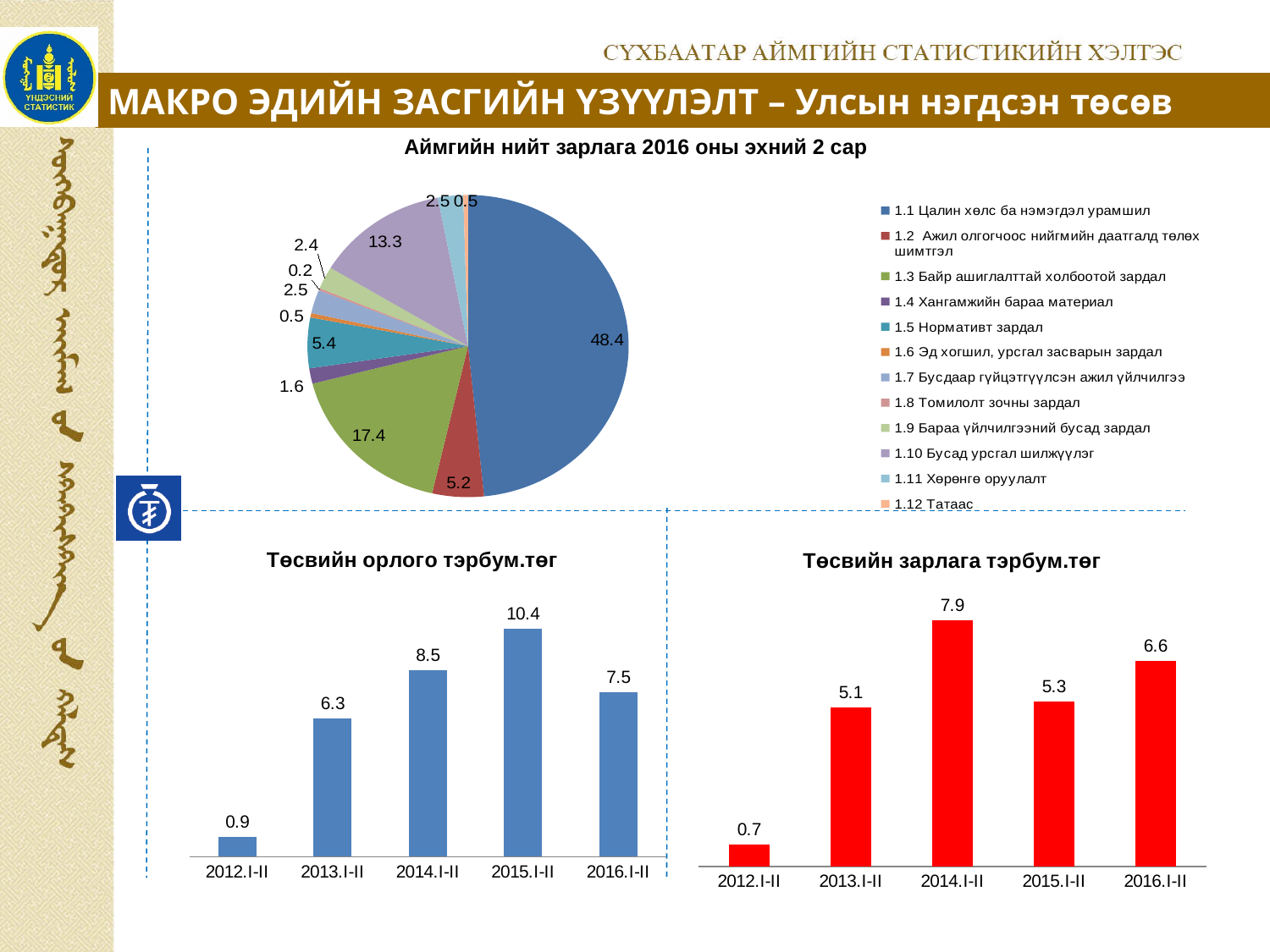
What kind of chart is the chart titled 'Аймгийн нийт зарлага 2016 оны эхний 2 сар'? pie chart In the bar chart titled 'Төсвийн зарлага тэрбум.төг', which period has the lowest value? 2012.I-II How many periods are shown on the x axis of the bar chart titled 'Төсвийн орлого тэрбум.төг'? 5 In the pie chart titled 'Аймгийн нийт зарлага 2016 оны эхний 2 сар', what is the value of the largest slice? 48.4 In the bar chart titled 'Төсвийн орлого тэрбум.төг', which period has the highest value? 2015.I-II In the bar chart titled 'Төсвийн орлого тэрбум.төг', what is the difference between the values for 2015.I-II and 2016.I-II? 2.9 In the bar chart titled 'Төсвийн зарлага тэрбум.төг', what is the value for 2016.I-II? 6.6 In the bar chart titled 'Төсвийн орлого тэрбум.төг', do the values rise or fall from 2012.I-II to 2015.I-II? rise In the bar chart titled 'Төсвийн орлого тэрбум.төг', what is the value for 2015.I-II? 10.4 How many entries does the legend of the pie chart titled 'Аймгийн нийт зарлага 2016 оны эхний 2 сар' list? 12 What colour are the bars in the chart titled 'Төсвийн зарлага тэрбум.төг'? red In the bar chart titled 'Төсвийн зарлага тэрбум.төг', which is larger: the value for 2014.I-II or the value for 2016.I-II? 2014.I-II